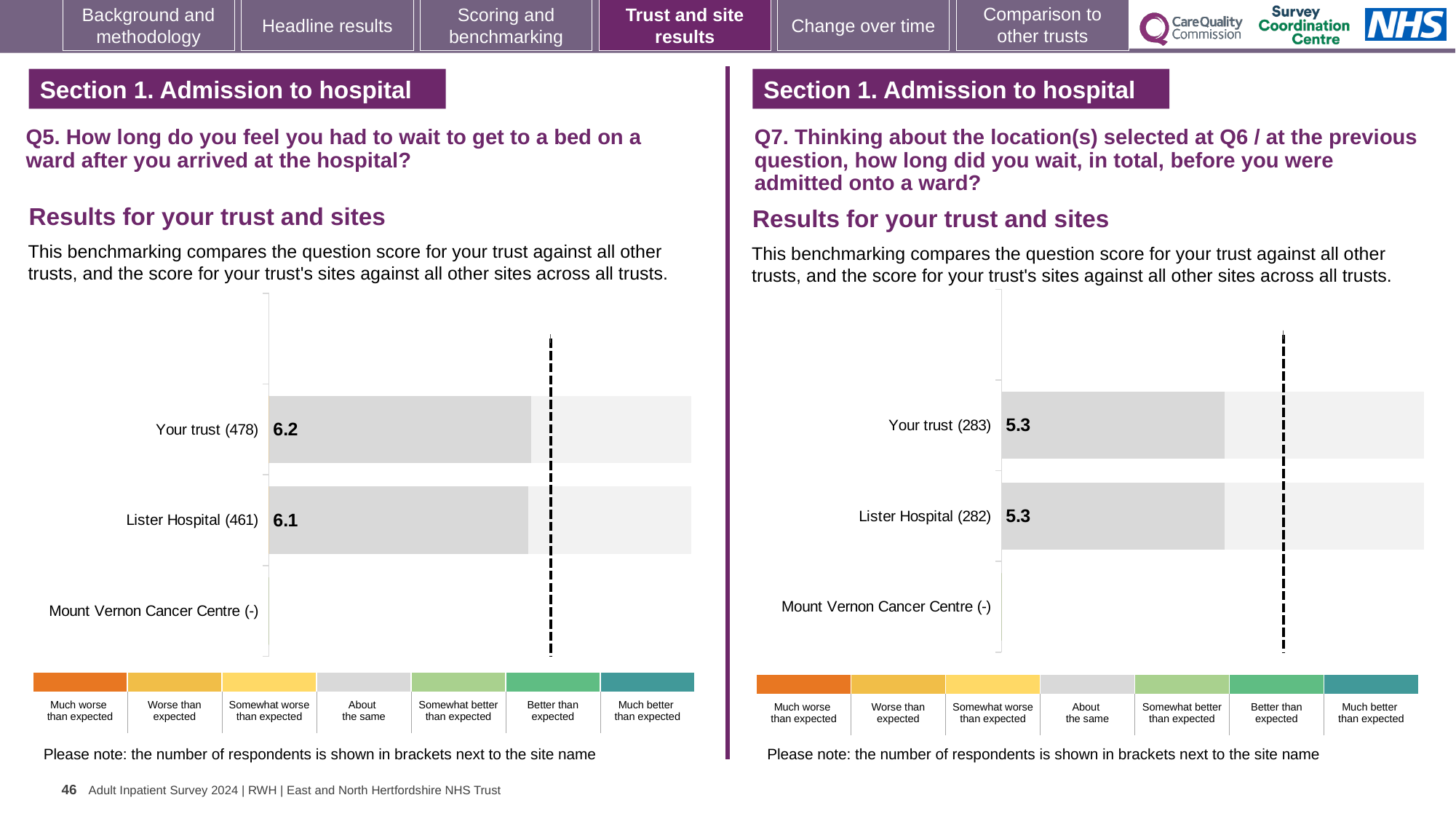
In the Q5 chart on the left, what is the score for Your trust? 6.2 In the Q5 chart on the left, how many respondents are shown in brackets for Your trust? 478 In the Q5 chart on the left, which has the higher score, Your trust or Lister Hospital? Your trust What kind of chart is the Q7 chart on the right? Bar chart In the Q7 chart on the right, what is the score for Your trust? 5.3 In the Q7 chart on the right, what is the score for Lister Hospital? 5.3 In the Q7 chart on the right, how many respondents are shown in brackets for Lister Hospital? 282 In the Q5 chart on the left, what is the difference between the scores for Your trust and Lister Hospital? 0.1 How many categories are listed on the vertical axis of the Q5 chart on the left? 3 In the Q5 chart on the left, what is the score for Lister Hospital? 6.1 In the Q7 chart on the right, what is the difference between the scores for Your trust and Lister Hospital? 0 In the Q7 chart on the right, which category has no score shown? Mount Vernon Cancer Centre